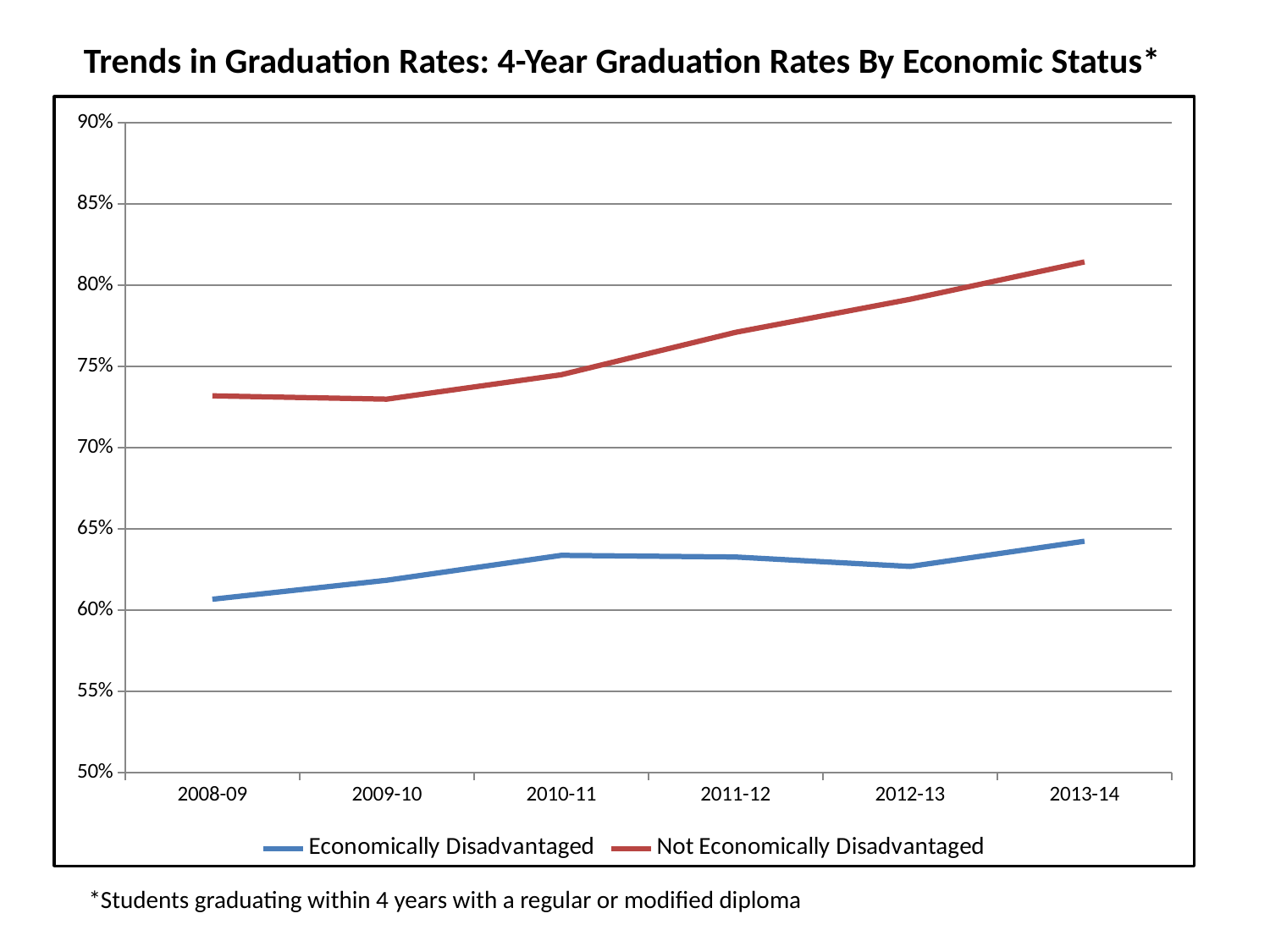
In which school year is the Economically Disadvantaged graduation rate lowest? 2008-09 Which series has the higher graduation rate in 2011-12, Economically Disadvantaged or Not Economically Disadvantaged? Not Economically Disadvantaged How many series does the legend list? 2 In which school year is the Not Economically Disadvantaged graduation rate highest? 2013-14 What kind of chart is shown on the slide? Line chart Is the Not Economically Disadvantaged graduation rate for 2008-09 greater or less than 75%? less Is the Economically Disadvantaged graduation rate for 2013-14 greater or less than 65%? less Which colour is used for the Economically Disadvantaged line? Blue How many school years are plotted along the x axis? 6 Does the Not Economically Disadvantaged graduation rate rise or fall from 2009-10 to 2013-14? Rise Is the Not Economically Disadvantaged graduation rate for 2013-14 greater or less than 80%? greater In which school year is the Economically Disadvantaged graduation rate highest? 2013-14